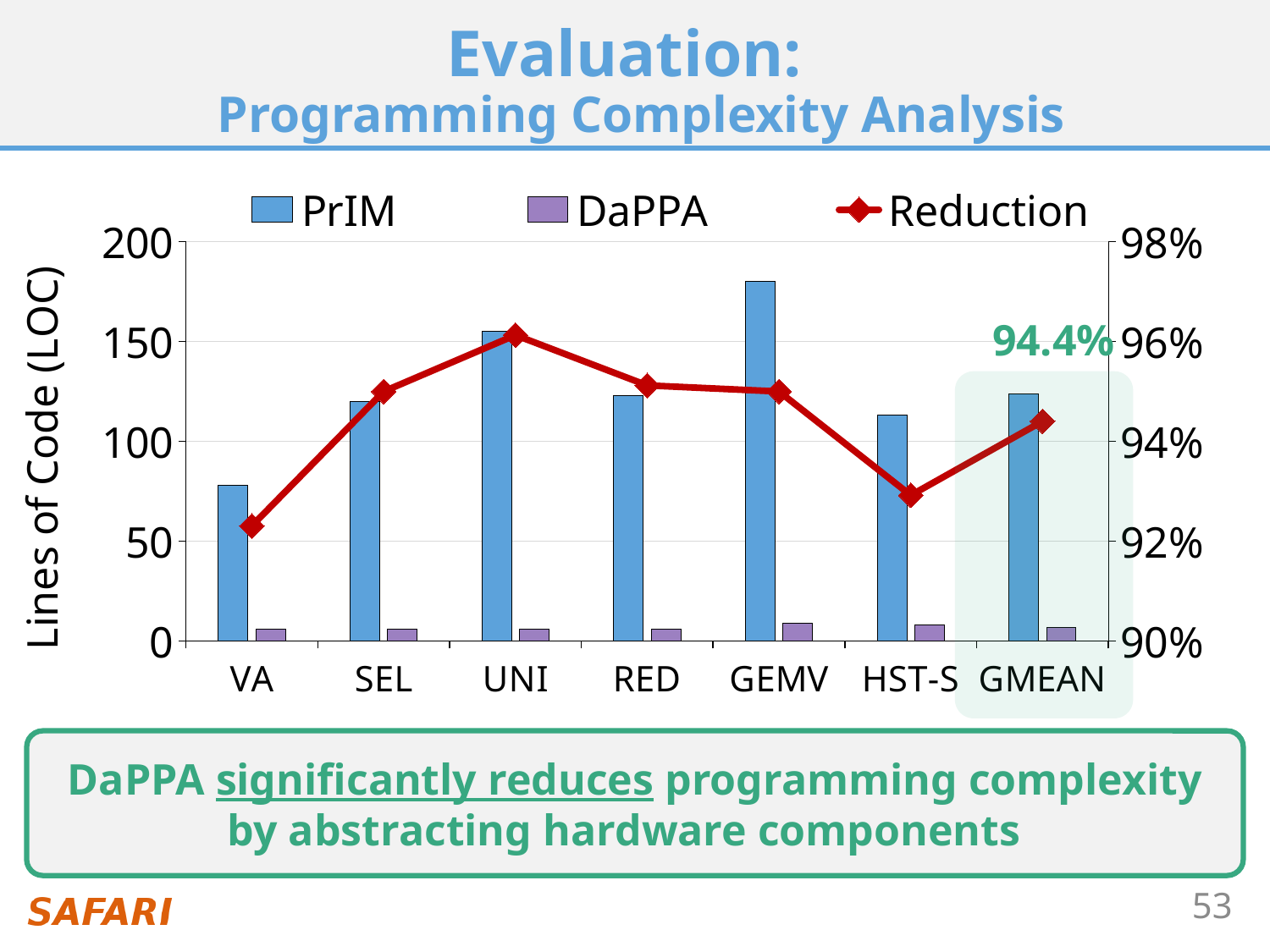
Which category has the highest Reduction value? UNI Is the Reduction value for HST-S greater or less than 94%? less Is the PrIM value for GEMV greater or less than 150? greater How many series does the legend list? 3 Which category has the lowest Reduction value? VA Which has more PrIM lines of code, GEMV or HST-S? GEMV What is the label of the left vertical axis? Lines of Code (LOC) Which category has the lowest PrIM lines of code? VA Is the PrIM value for VA greater or less than 100? less Which category has the highest PrIM lines of code? GEMV What is the Reduction value shown for GMEAN? 94.4% How many categories are shown on the x axis? 7